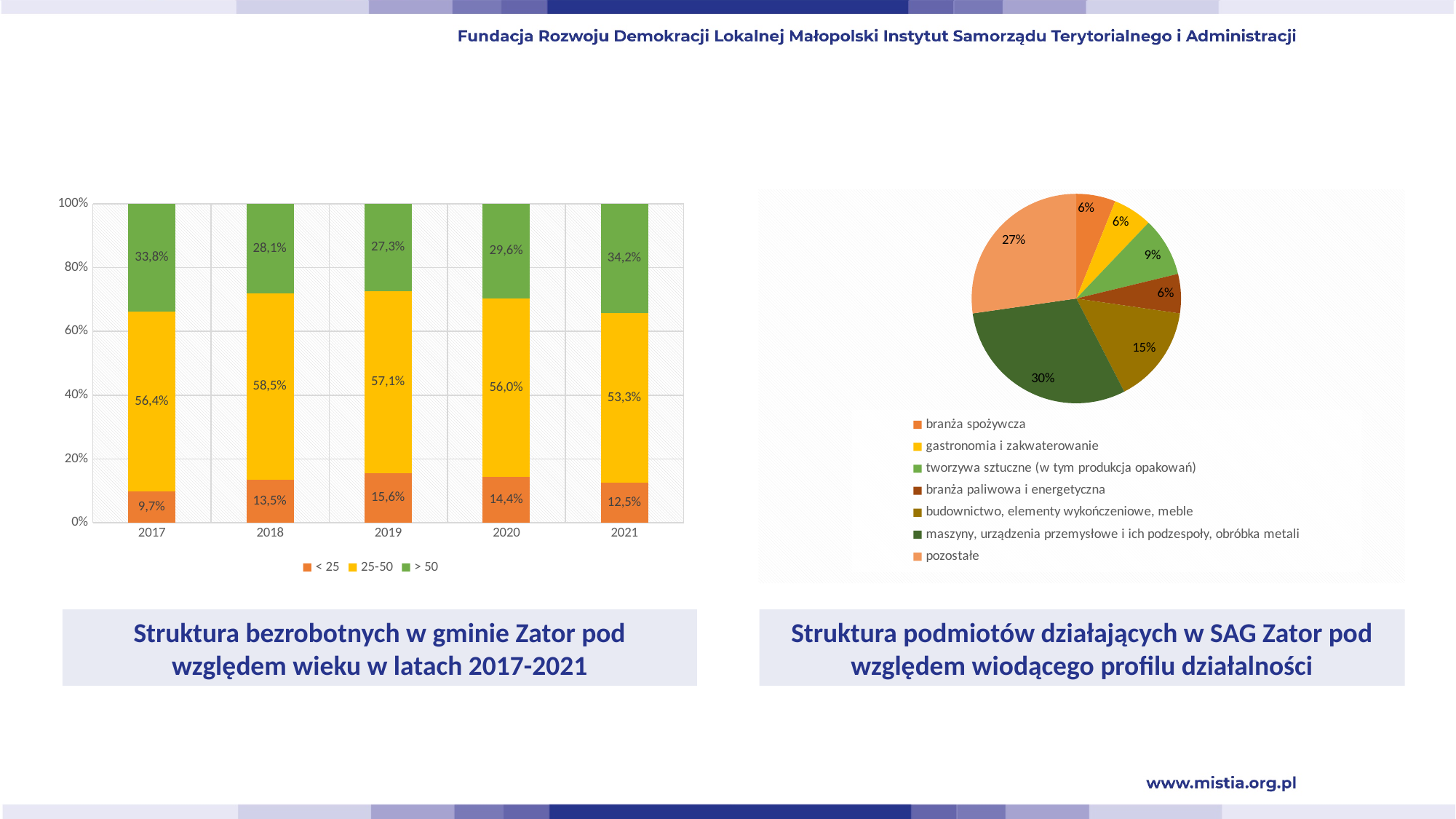
In the left chart (Struktura bezrobotnych w gminie Zator), what is the difference between the '> 50' values in 2021 and 2020? 4,6 percentage points In the left chart (Struktura bezrobotnych w gminie Zator), which year has the highest value for the '< 25' series? 2019 In the right chart (Struktura podmiotów działających w SAG Zator), how many categories does the legend list? 7 In the left chart (Struktura bezrobotnych w gminie Zator), how many series does the legend list? 3 In the right chart (Struktura podmiotów działających w SAG Zator), what share does 'maszyny, urządzenia przemysłowe i ich podzespoły, obróbka metali' have? 30% What kind of chart is the right chart (Struktura podmiotów działających w SAG Zator)? Pie chart In the left chart (Struktura bezrobotnych w gminie Zator), what is the value for the '> 50' series in 2021? 34,2% In the left chart (Struktura bezrobotnych w gminie Zator), which year has the lowest value for the '> 50' series? 2019 In the left chart (Struktura bezrobotnych w gminie Zator), how many years are shown on the x axis? 5 In the left chart (Struktura bezrobotnych w gminie Zator), what is the value for the '< 25' series in 2019? 15,6% In the right chart (Struktura podmiotów działających w SAG Zator), what share does 'budownictwo, elementy wykończeniowe, meble' have? 15% In the left chart (Struktura bezrobotnych w gminie Zator), what is the value for the '25-50' series in 2018? 58,5%